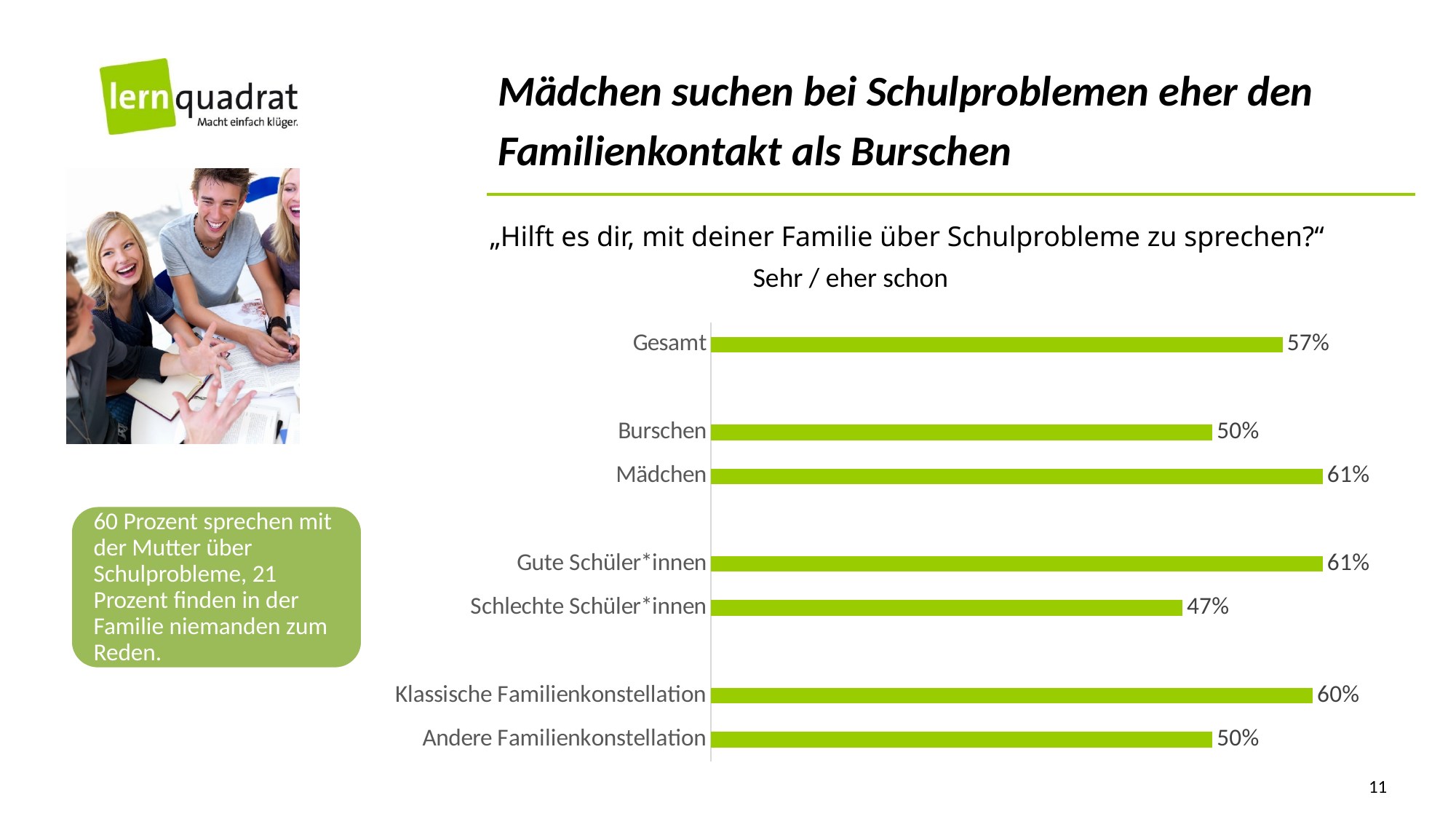
What is the difference between the values for Gute Schüler*innen and Schlechte Schüler*innen? 14% What is the value for Schlechte Schüler*innen? 47% What is the value for Mädchen? 61% Which is larger, the value for Klassische Familienkonstellation or Andere Familienkonstellation? Klassische Familienkonstellation What question is the chart based on, as shown above the chart? „Hilft es dir, mit deiner Familie über Schulprobleme zu sprechen?“ What is the difference between the values for Mädchen and Burschen? 11% What kind of chart is shown on the slide? Bar chart What is the value for Gesamt? 57% How many categories are shown in the chart? 7 What is the value for Klassische Familienkonstellation? 60% Which category has the lowest value? Schlechte Schüler*innen What is the value for Burschen? 50%